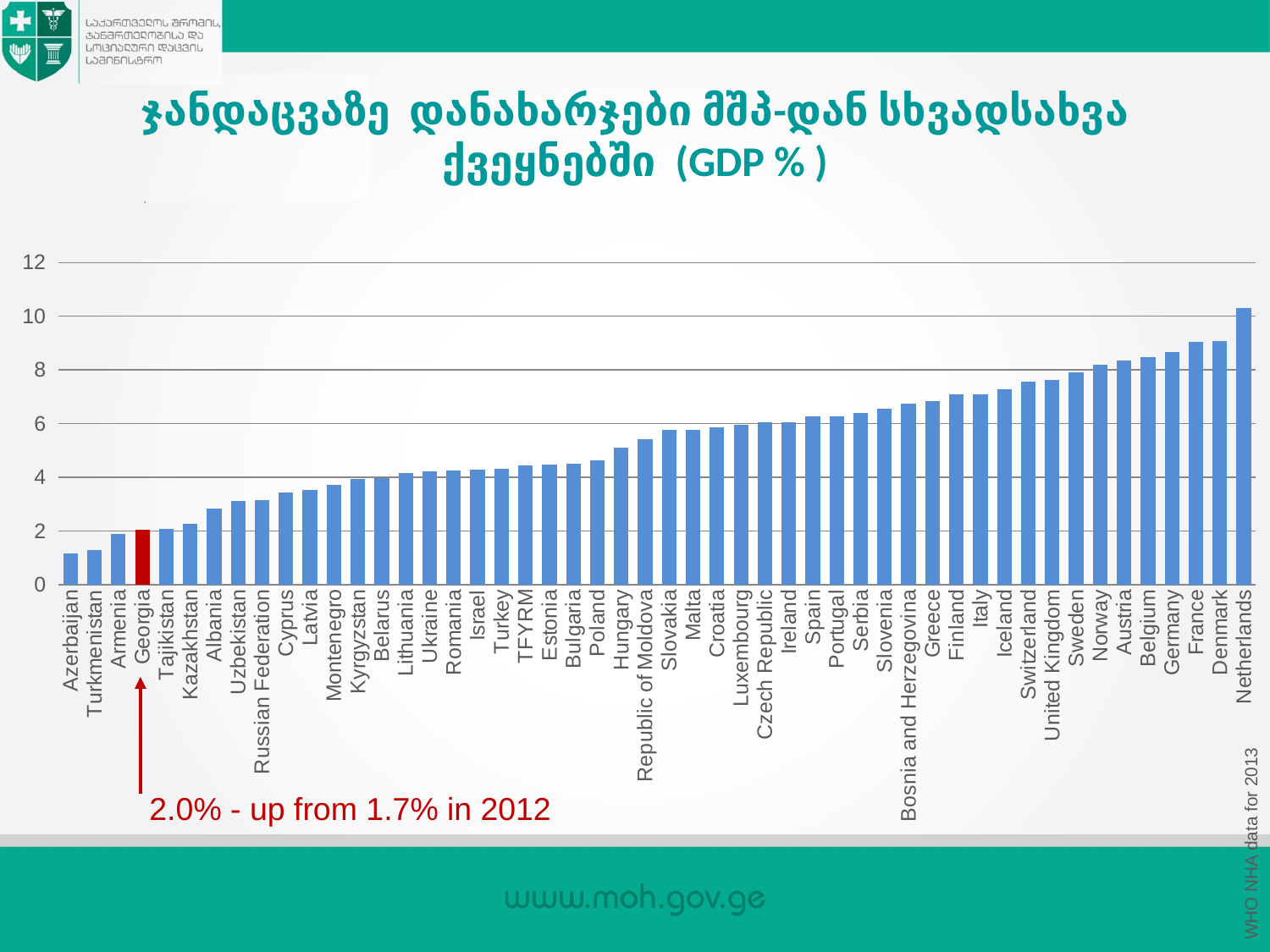
Which country has the lowest value in the chart? Azerbaijan According to the annotation, what was Georgia's value in 2012? 1.7% Is the value for Azerbaijan greater or less than 2? less What kind of chart is shown on the slide? bar chart Is the value for Netherlands greater or less than 10? greater Is the value for France greater or less than 8? greater Which country's bar is highlighted in red? Georgia Do the values rise or fall moving from left to right along the x axis? rise What is the value for Georgia according to the annotation on the chart? 2.0% Which country has the highest value in the chart? Netherlands Which has the larger value, Netherlands or Denmark? Netherlands